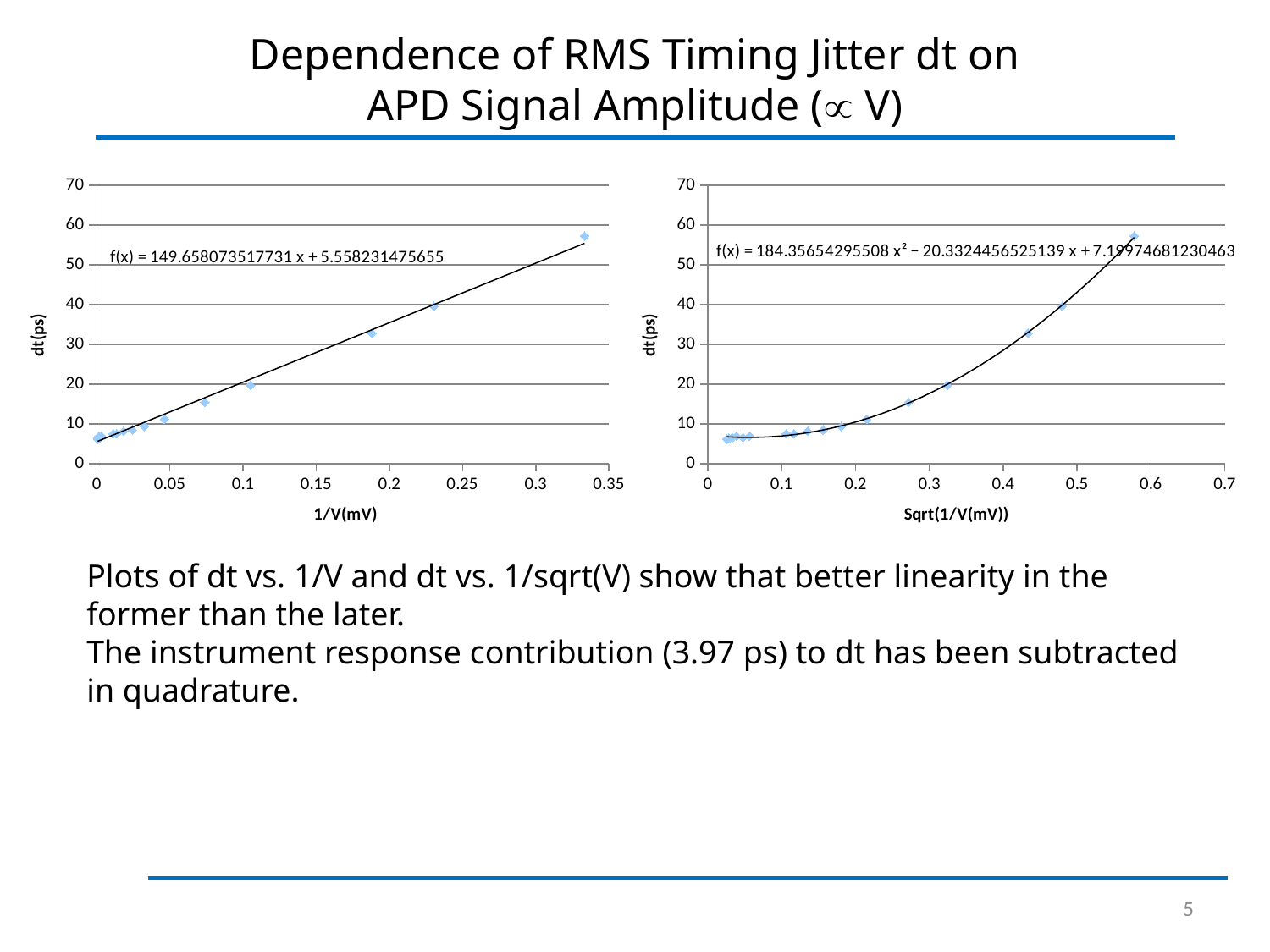
In the left chart, is the dt(ps) value of the rightmost data point greater or less than 50? greater What kind of chart is the left chart (dt vs. 1/V(mV))? scatter chart What is the x-axis label of the right chart? Sqrt(1/V(mV)) In the left chart, is the dt(ps) value of the data point near 1/V(mV) = 0.19 greater or less than 30? greater In the left chart, which data point has the highest dt(ps) value: the one at the far right or the one at the far left? the one at the far right What kind of chart is the right chart (dt vs. Sqrt(1/V(mV)))? scatter chart In the right chart, is the dt(ps) value of the rightmost data point greater or less than 50? greater In the left chart, do the dt(ps) values rise or fall as 1/V(mV) increases? rise In the right chart, do the dt(ps) values rise or fall as Sqrt(1/V(mV)) increases? rise What is the slope of the fitted line shown in the left chart's equation? 149.658073517731